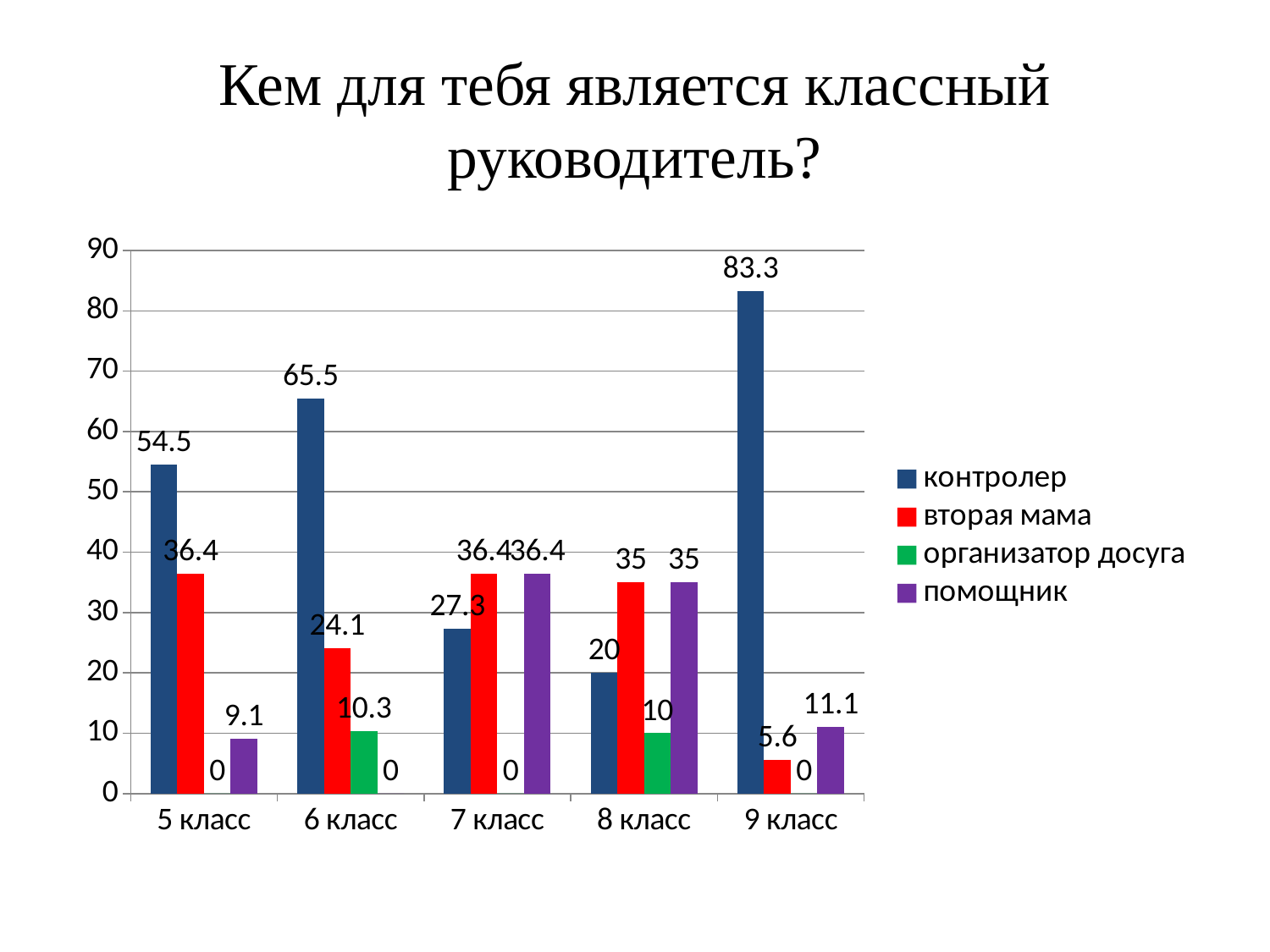
Which class has the lowest value for вторая мама? 9 класс What is the difference between the контролер values for 9 класс and 5 класс? 28.8 What kind of chart is shown on the slide? bar chart How many series does the legend list? 4 What is the value for вторая мама in 6 класс? 24.1 How many classes (categories) are shown on the x axis? 5 What is the value for контролер in 9 класс? 83.3 What is the value for организатор досуга in 8 класс? 10 What is the title of the chart on the slide? Кем для тебя является классный руководитель? Which is larger in 7 класс: контролер or вторая мама? вторая мама Which class has the highest value for контролер? 9 класс What is the value for помощник in 5 класс? 9.1